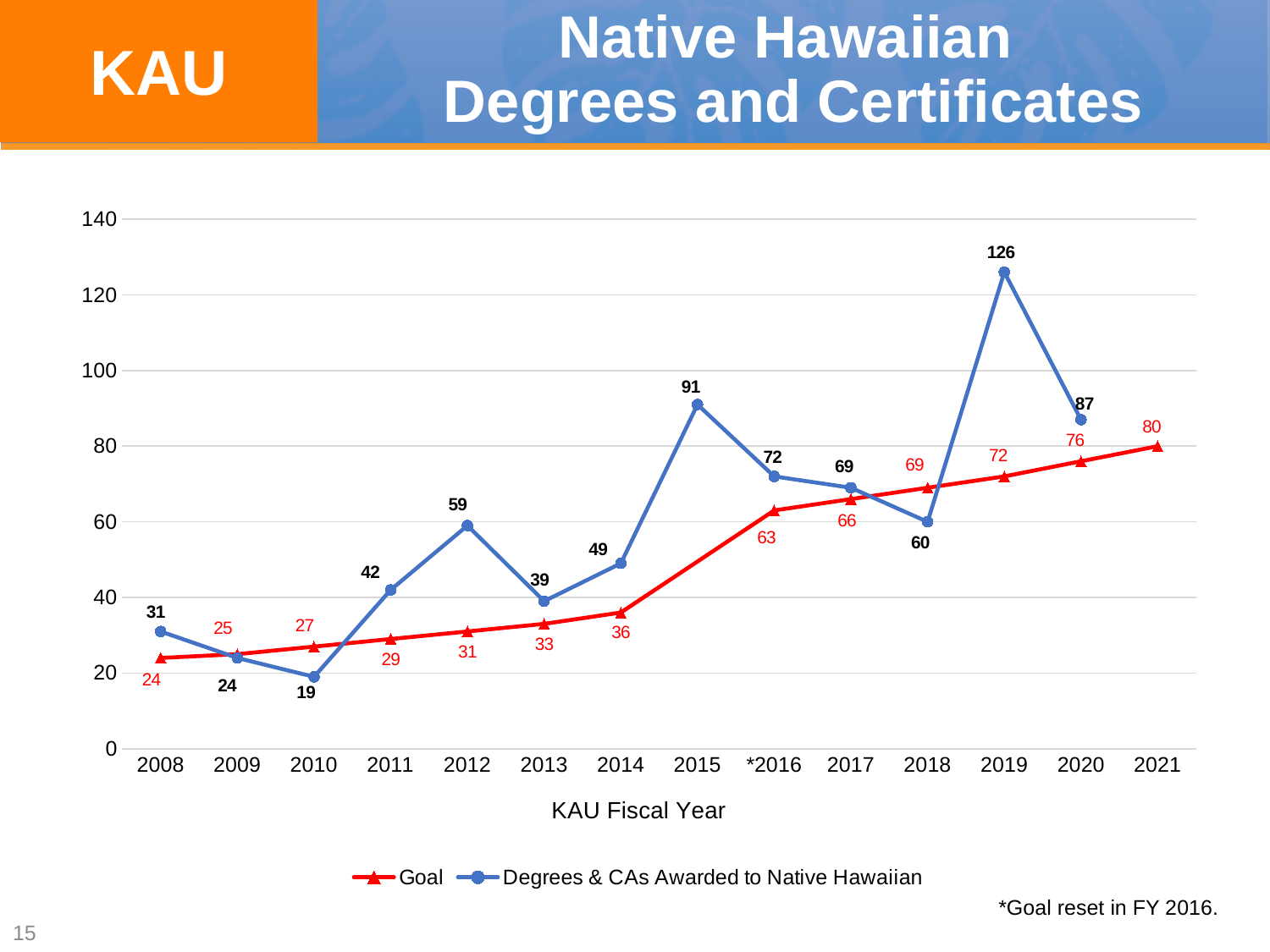
In 2018, which was larger: the Goal or the Degrees & CAs Awarded to Native Hawaiian? Goal How many fiscal years are shown on the x axis? 14 In which year was the number of Degrees & CAs Awarded to Native Hawaiian the highest? 2019 Does the Goal line rise or fall from 2008 to 2021? Rises How many series does the legend list? 2 In which year was the number of Degrees & CAs Awarded to Native Hawaiian the lowest? 2010 What is the difference between the Degrees & CAs awarded in 2019 and in 2020? 39 What was the Goal value for 2021? 80 Is the number of Degrees & CAs awarded in 2015 greater or less than 80? greater What type of chart is shown on the slide? Line chart How many Degrees & CAs were awarded to Native Hawaiians in 2019? 126 What is the label of the x axis? KAU Fiscal Year